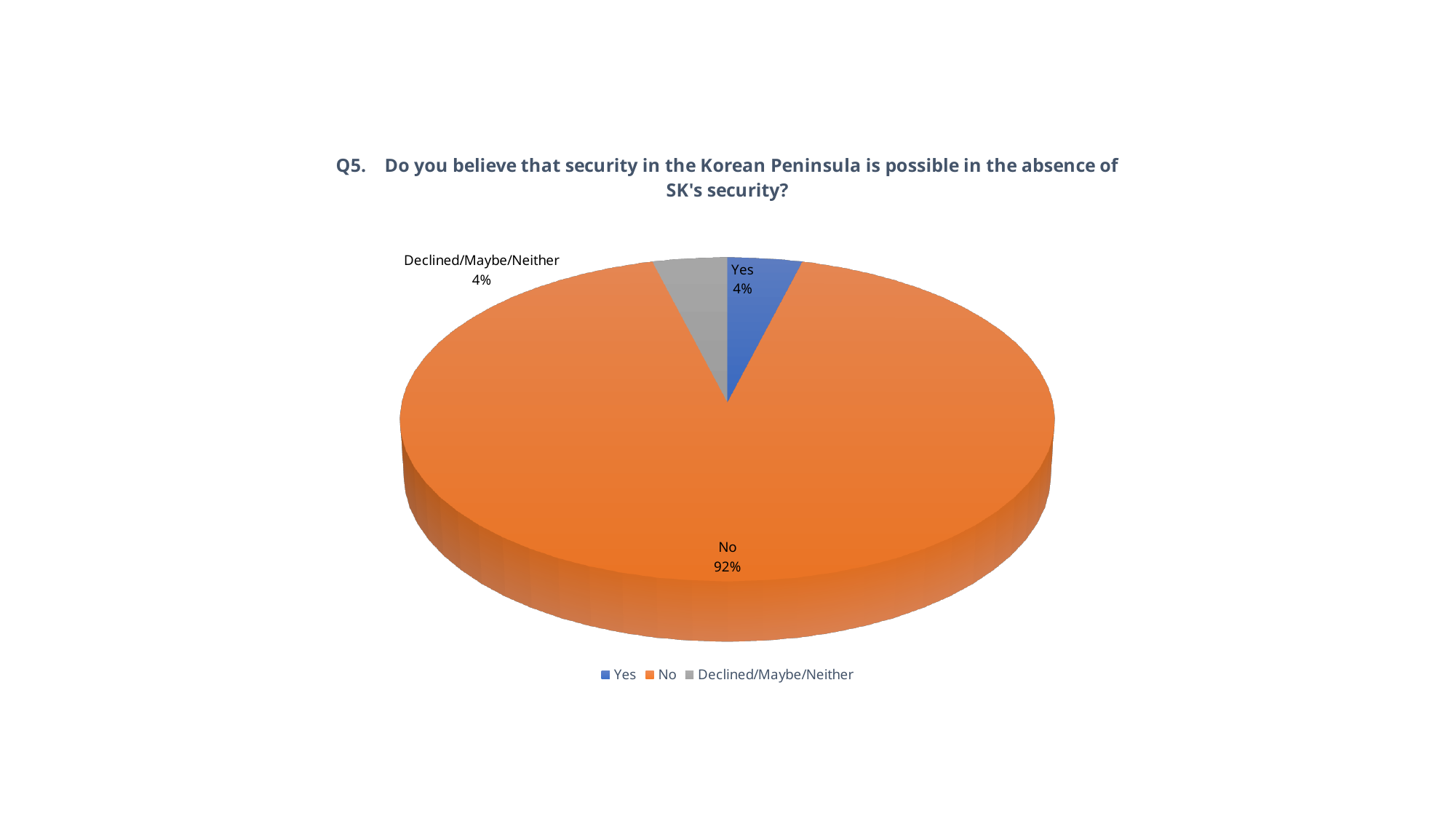
What colour is the "No" slice? Orange How many slices does the pie chart have? 3 What kind of chart is shown on the slide? Pie chart What percentage is shown for the "Declined/Maybe/Neither" slice? 4% Which response has the largest share of the pie? No What percentage of respondents answered "Yes"? 4% What is the difference in percentage points between the "No" and "Yes" slices? 88 What share of the pie do the "Yes" and "Declined/Maybe/Neither" slices make up together? 8% What percentage of respondents answered "No"? 92% What question number is shown in the chart title? Q5 Which is larger, the "No" slice or the "Declined/Maybe/Neither" slice? No How many entries does the legend list? 3